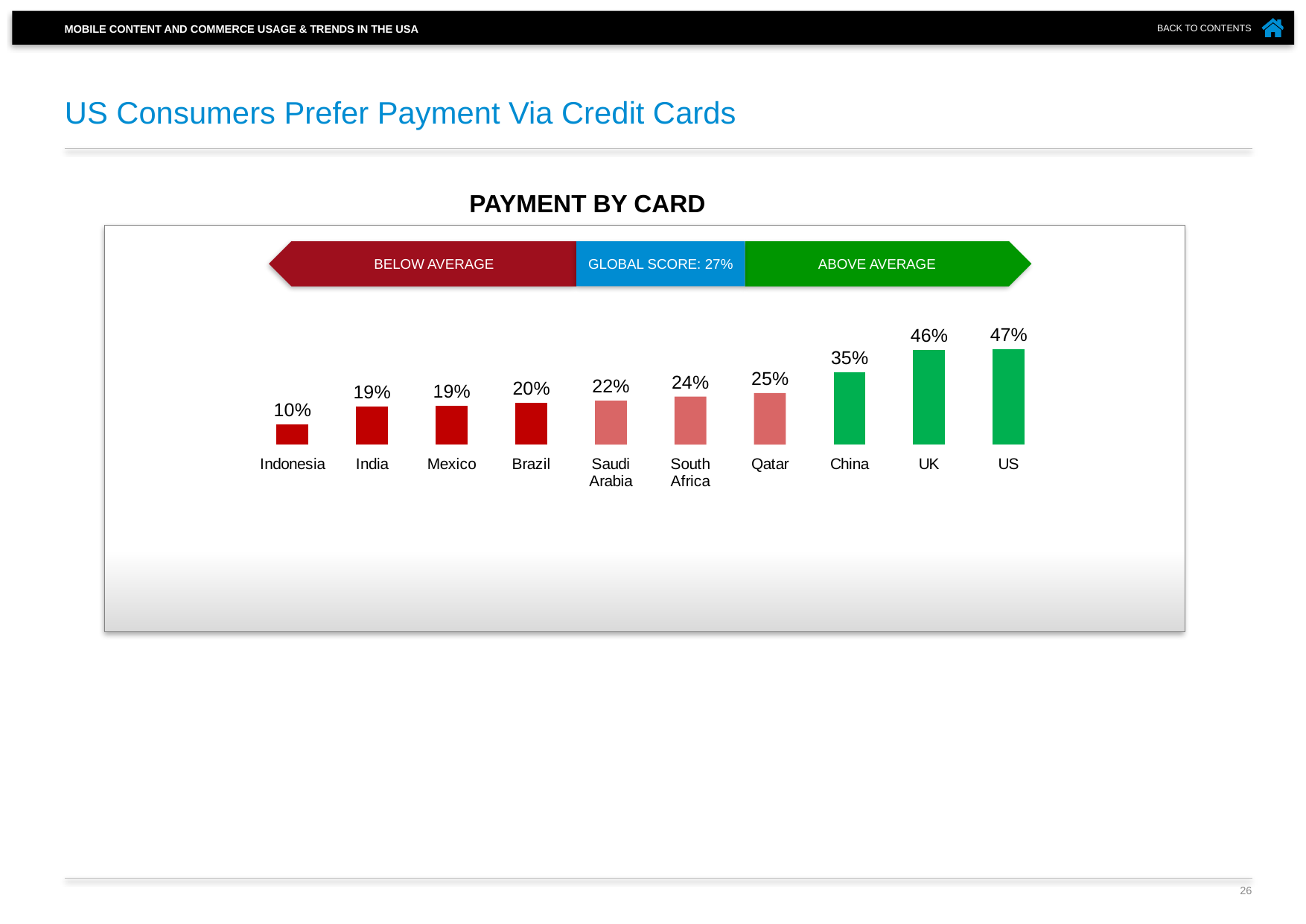
Which country has the highest value in the Payment by Card chart? US What global score is shown in the banner above the Payment by Card chart? 27% Which country has the lowest value in the Payment by Card chart? Indonesia Which has a larger value in the Payment by Card chart, South Africa or Brazil? South Africa What is the value for China in the Payment by Card chart? 35% Do the values in the Payment by Card chart rise or fall from left to right? Rise What is the value for the US in the Payment by Card chart? 47% How many countries are shown in the Payment by Card chart? 10 What is the difference between the values for Qatar and Indonesia in the Payment by Card chart? 15% What is the difference between the values for the UK and China in the Payment by Card chart? 11% What kind of chart is the Payment by Card chart? Bar chart What is the value for Saudi Arabia in the Payment by Card chart? 22%